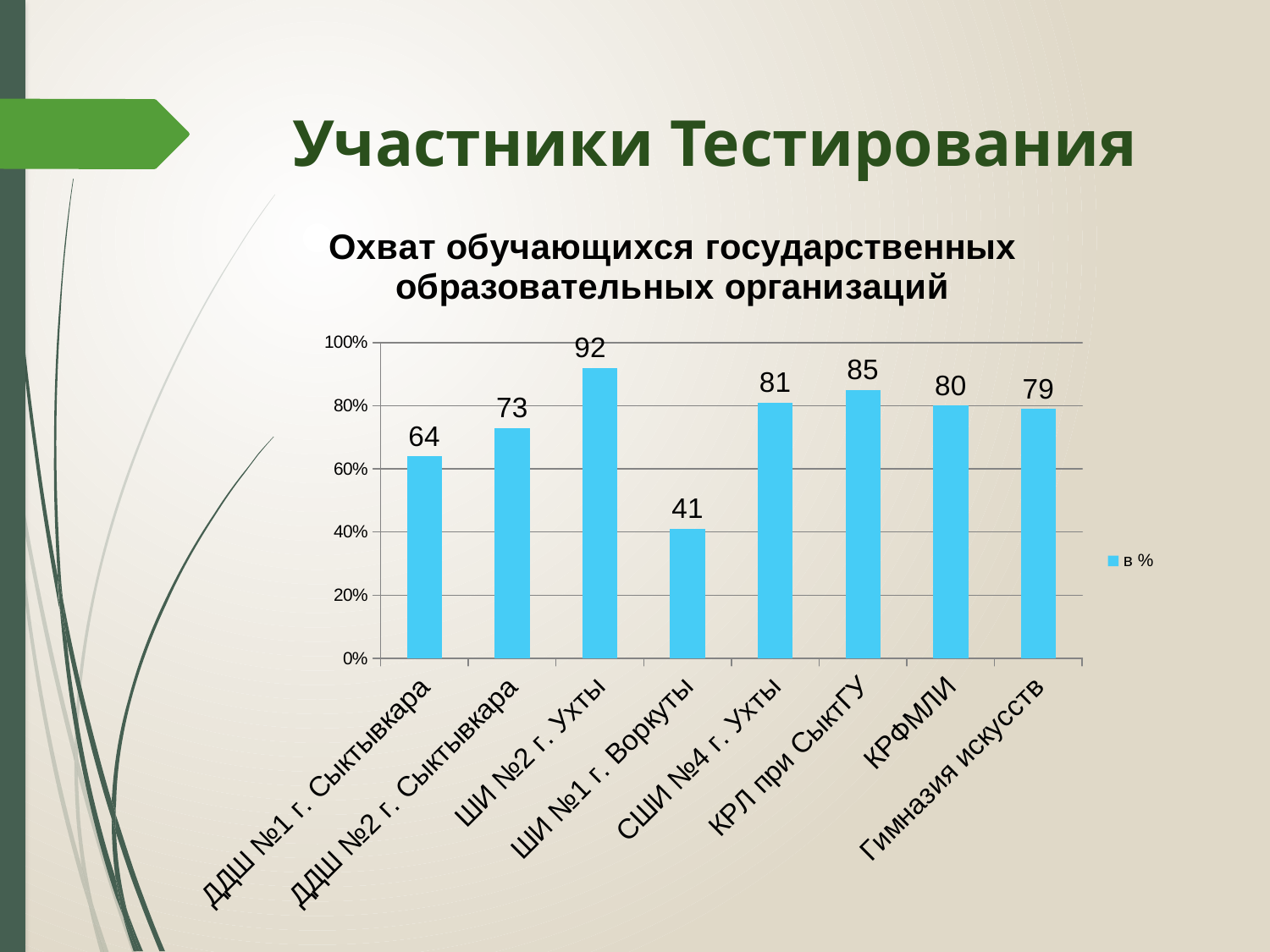
Which category has the lowest value? ШИ №1 г. Воркуты Is the value for ШИ №1 г. Воркуты greater or less than 60%? less What is the value for ШИ №2 г. Ухты? 92 What is the difference between the values for ШИ №2 г. Ухты and ШИ №1 г. Воркуты? 51 What kind of chart is shown? bar chart What is the value for ДДШ №1 г. Сыктывкара? 64 Which is larger, the value for ДДШ №2 г. Сыктывкара or the value for КРФМЛИ? КРФМЛИ How many series does the legend list? 1 What is the value for КРЛ при СыктГУ? 85 What is the legend entry for the series? в % How many categories are shown on the x axis? 8 Which category has the highest value? ШИ №2 г. Ухты